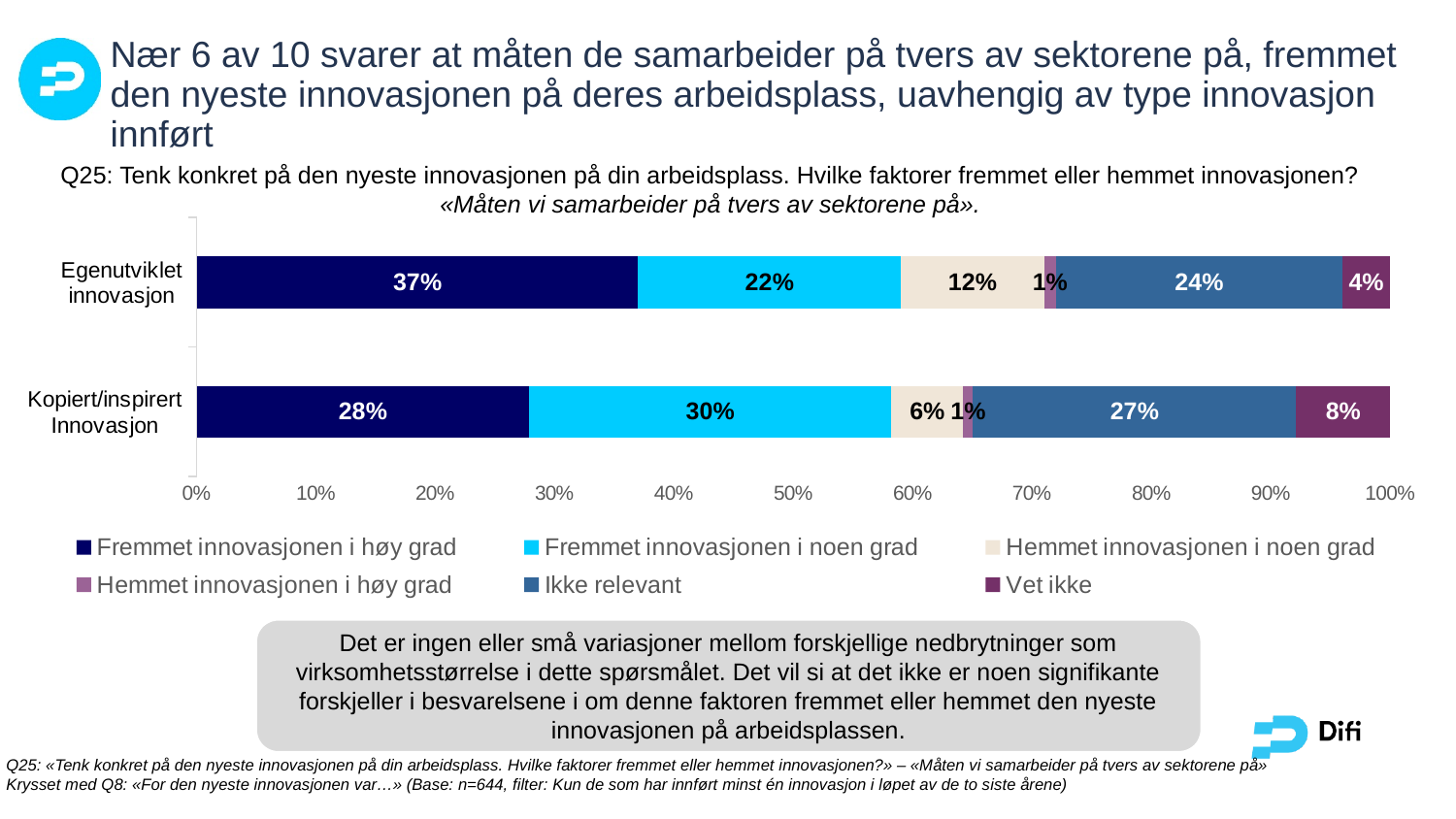
What is the value of "Fremmet innovasjonen i høy grad" for Egenutviklet innovasjon? 37% What is the value of "Vet ikke" for Kopiert/inspirert Innovasjon? 8% What is the value of "Fremmet innovasjonen i noen grad" for Kopiert/inspirert Innovasjon? 30% How many categories are plotted on the chart? 2 Which category has the higher value for "Fremmet innovasjonen i høy grad"? Egenutviklet innovasjon How many series does the legend list? 6 What is the value of "Ikke relevant" for Egenutviklet innovasjon? 24% What kind of chart is shown on the slide? Stacked bar chart What is the difference between the "Hemmet innovasjonen i noen grad" values for Egenutviklet innovasjon and Kopiert/inspirert Innovasjon? 6% What is the difference between the "Vet ikke" values for Kopiert/inspirert Innovasjon and Egenutviklet innovasjon? 4% Which legend entry is shown in the lightest (beige) colour? Hemmet innovasjonen i noen grad What is the value of "Hemmet innovasjonen i noen grad" for Egenutviklet innovasjon? 12%